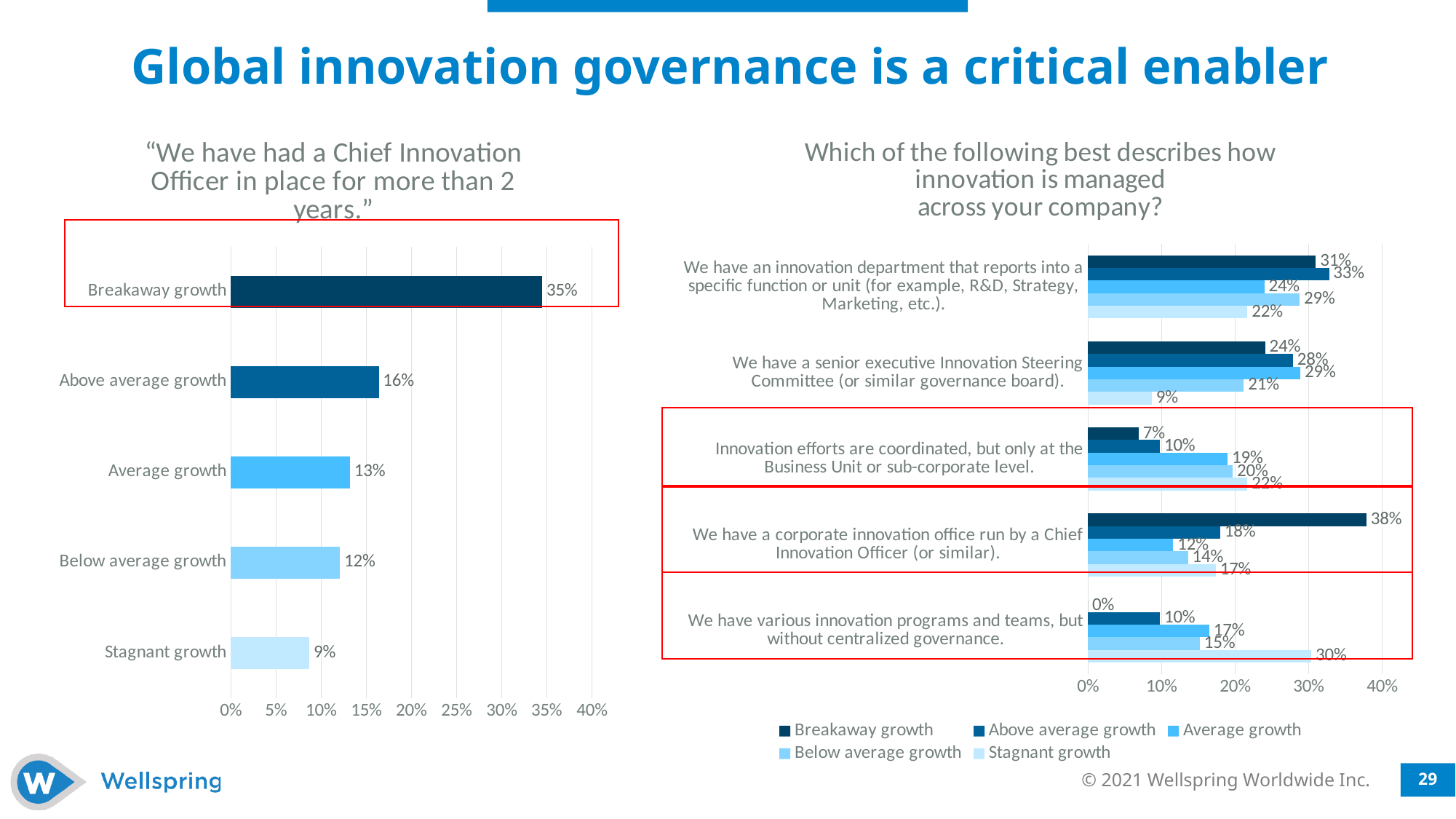
In the left chart ("We have had a Chief Innovation Officer in place for more than 2 years"), what is the difference between Breakaway growth and Above average growth? 19 percentage points In the left chart ("We have had a Chief Innovation Officer in place for more than 2 years"), which growth category has the lowest value? Stagnant growth What type of chart is the left chart ("We have had a Chief Innovation Officer in place for more than 2 years")? bar chart In the right chart ("Which of the following best describes how innovation is managed across your company?"), how many series does the legend list? 5 In the left chart ("We have had a Chief Innovation Officer in place for more than 2 years"), how many growth categories are shown? 5 In the right chart ("Which of the following best describes how innovation is managed across your company?"), what is the Breakaway growth value for "We have various innovation programs and teams, but without centralized governance"? 0% In the left chart ("We have had a Chief Innovation Officer in place for more than 2 years"), do the values rise or fall going from Breakaway growth down to Stagnant growth? fall In the right chart ("Which of the following best describes how innovation is managed across your company?"), what is the Breakaway growth value for "We have a corporate innovation office run by a Chief Innovation Officer (or similar)"? 38% In the left chart ("We have had a Chief Innovation Officer in place for more than 2 years"), what is the value for Breakaway growth? 35% In the right chart ("Which of the following best describes how innovation is managed across your company?"), which series has the highest value for "We have a senior executive Innovation Steering Committee (or similar governance board)"? Average growth In the right chart ("Which of the following best describes how innovation is managed across your company?"), for "Innovation efforts are coordinated, but only at the Business Unit or sub-corporate level", which is larger: Breakaway growth or Stagnant growth? Stagnant growth In the right chart ("Which of the following best describes how innovation is managed across your company?"), what is the Stagnant growth value for "We have various innovation programs and teams, but without centralized governance"? 30%